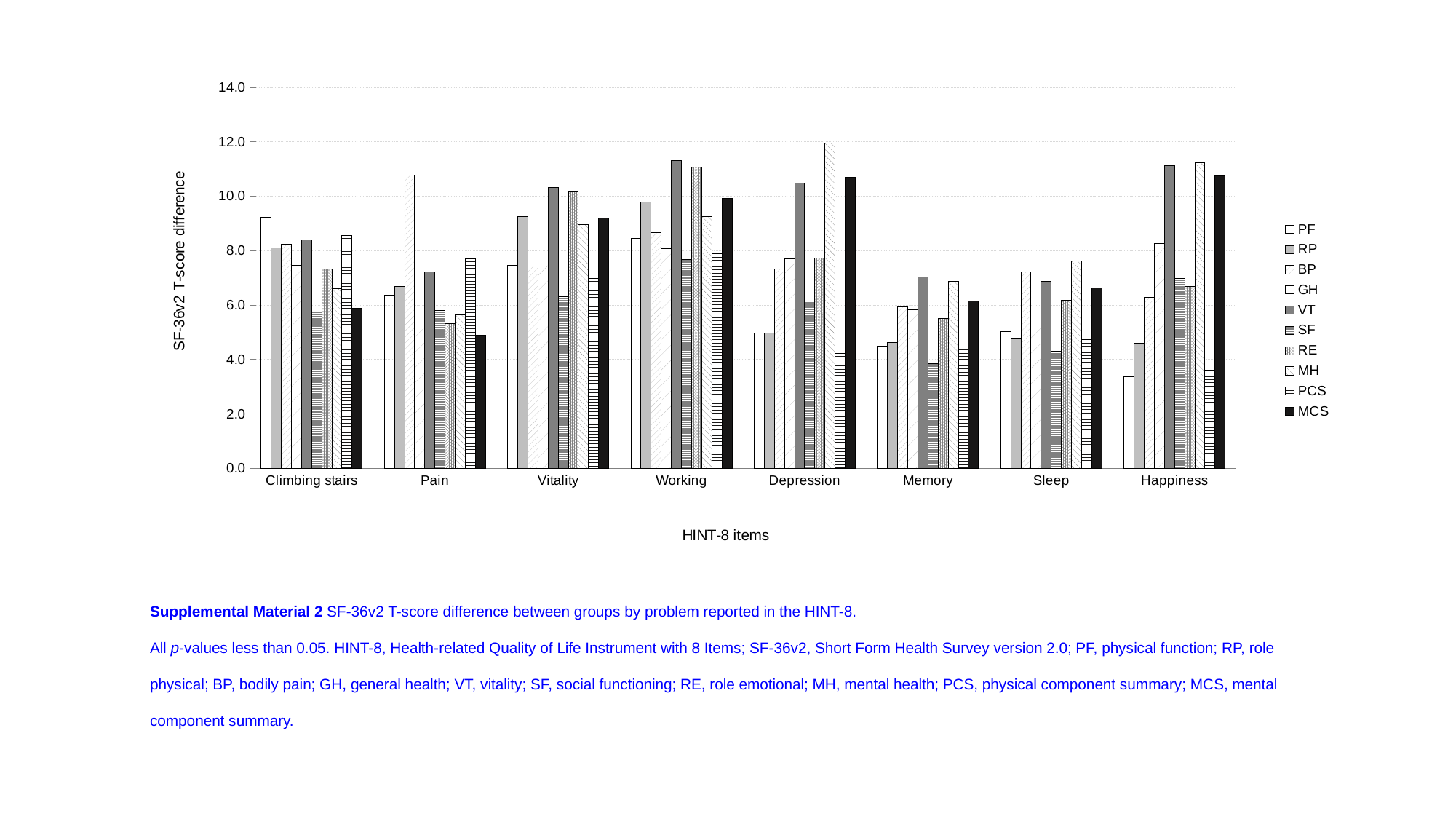
Is the value for PF in the Happiness category greater or less than 4.0? less In the Happiness category, which is larger, the value for VT or the value for PCS? VT What is the title of the horizontal axis? HINT-8 items Which series has the highest value in the Depression category? MH How many series does the legend list? 10 Is the value for VT in the Working category greater or less than 10.0? greater What kind of chart is shown on the slide? bar chart Is the value for MCS in the Climbing stairs category greater or less than 8.0? less How many HINT-8 item categories are shown on the x axis? 8 What is the title of the vertical axis? SF-36v2 T-score difference Which series has the highest value in the Pain category? BP